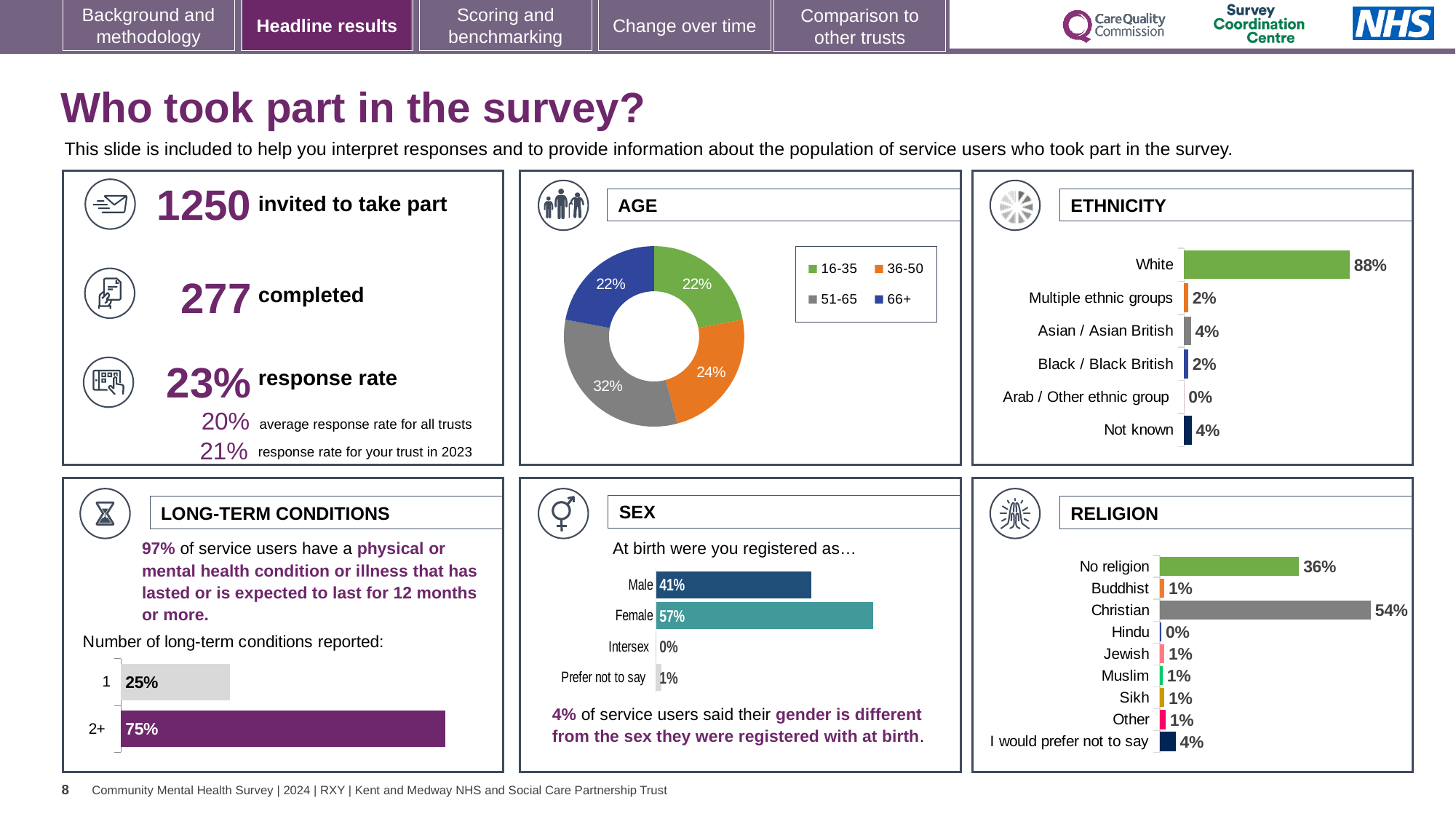
In the SEX chart, which is larger, Male or Female? Female How many categories are shown in the ETHNICITY chart? 6 In the AGE chart, which age group has the largest share? 51-65 In the ETHNICITY chart, what is the value for White? 88% In the AGE chart, what share of respondents were aged 51-65? 32% In the RELIGION chart, which category has the highest value? Christian In the ETHNICITY chart, what is the difference between White and Asian / Asian British? 84% What kind of chart is the AGE chart? Donut (pie) chart In the LONG-TERM CONDITIONS chart, what percentage reported 2+ conditions? 75% How many entries does the legend of the AGE chart list? 4 In the SEX chart, what is the value for Prefer not to say? 1% How many categories are shown in the RELIGION chart? 9